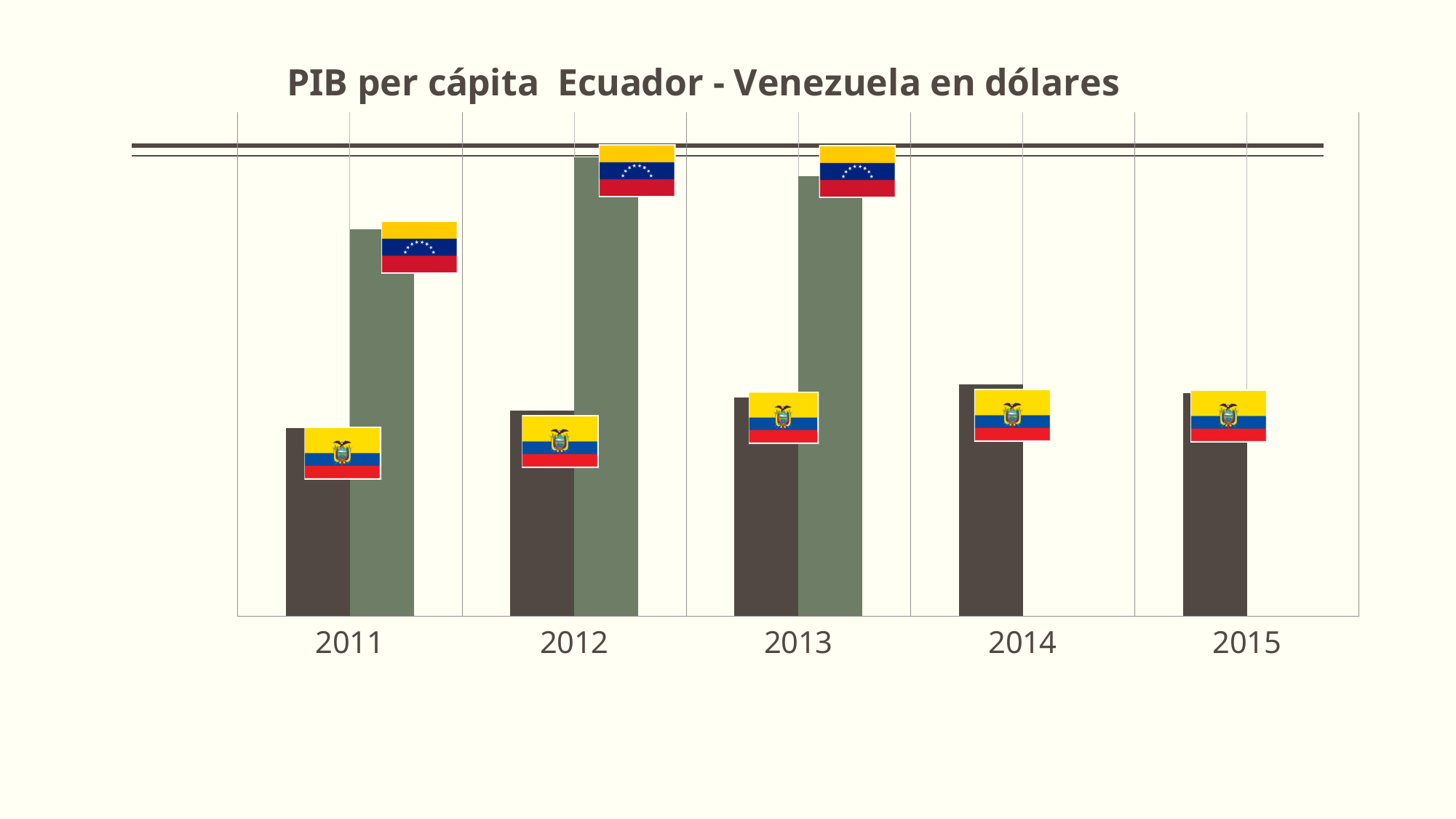
In 2011, which country has the higher PIB per cápita, Ecuador or Venezuela? Venezuela Does the Ecuador PIB per cápita rise or fall from 2011 to 2014? Rise In which year is the Ecuador bar the lowest? 2011 What is the title of the chart? PIB per cápita Ecuador - Venezuela en dólares Which country's bars are marked with the flag showing a coat of arms on a yellow, blue and red background? Ecuador What kind of chart is shown on the slide? Bar chart In which year is the Venezuela bar the highest? 2012 In 2013, which country has the higher PIB per cápita, Ecuador or Venezuela? Venezuela Which years are shown on the x axis of the chart? 2011, 2012, 2013, 2014, 2015 For how many years does the chart show a Venezuela bar? 3 How many countries are compared in the chart? 2 How many years are shown on the x axis of the chart? 5